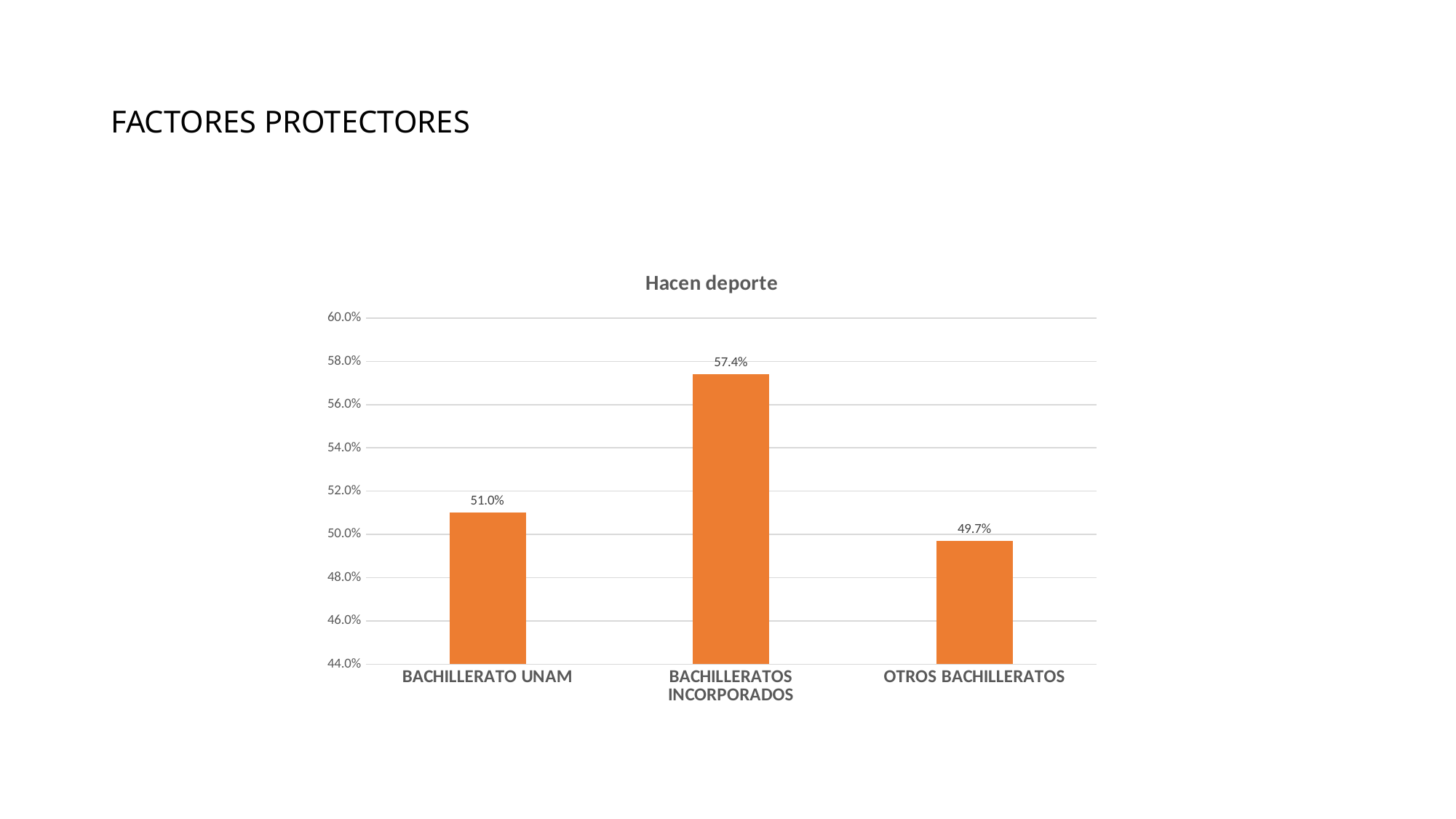
How many categories are shown in the chart? 3 Is the value for BACHILLERATOS INCORPORADOS greater or less than 56.0%? greater What kind of chart is shown on the slide? bar chart What is the value for BACHILLERATO UNAM? 51.0% What is the title of the chart? Hacen deporte What is the difference between the values for BACHILLERATOS INCORPORADOS and BACHILLERATO UNAM? 6.4% Which category has the highest value? BACHILLERATOS INCORPORADOS What is the difference between the values for BACHILLERATO UNAM and OTROS BACHILLERATOS? 1.3% Which is larger, the value for BACHILLERATO UNAM or the value for OTROS BACHILLERATOS? BACHILLERATO UNAM What is the value for BACHILLERATOS INCORPORADOS? 57.4% What is the value for OTROS BACHILLERATOS? 49.7% Which category has the lowest value? OTROS BACHILLERATOS